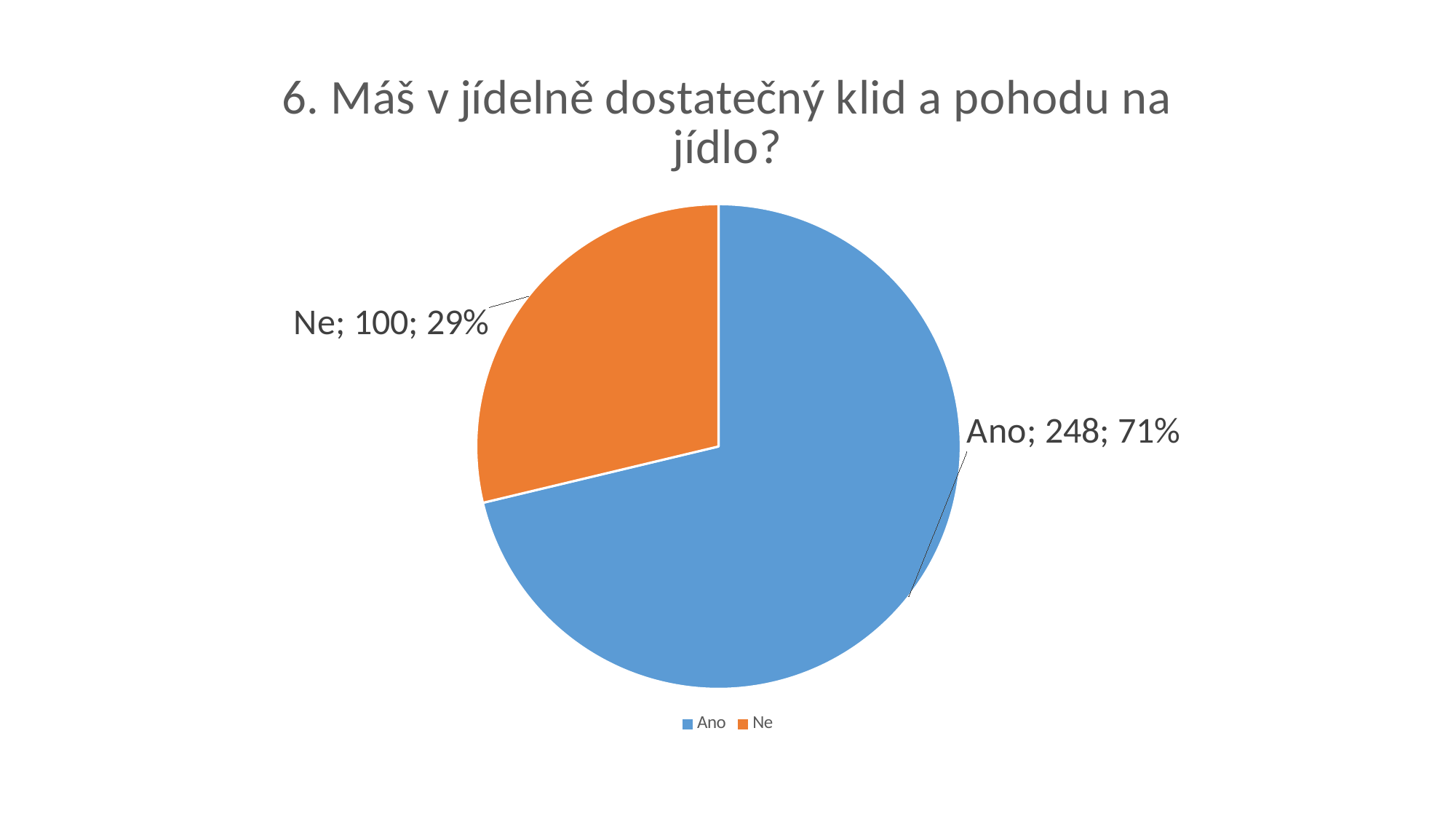
What kind of chart is shown on the slide? pie chart What is the difference between the values for Ano and Ne? 148 What is the value for Ano? 248 How many slices does the pie chart have? 2 Which is larger, the value for Ano or the value for Ne? Ano What is the value for Ne? 100 Which category has the largest slice? Ano What share of the pie does the Ano slice represent? 71% What share of the pie does the Ne slice represent? 29% What is the total of all slices in the pie chart? 348 What colour is the Ne slice? orange Which category has the smallest slice? Ne